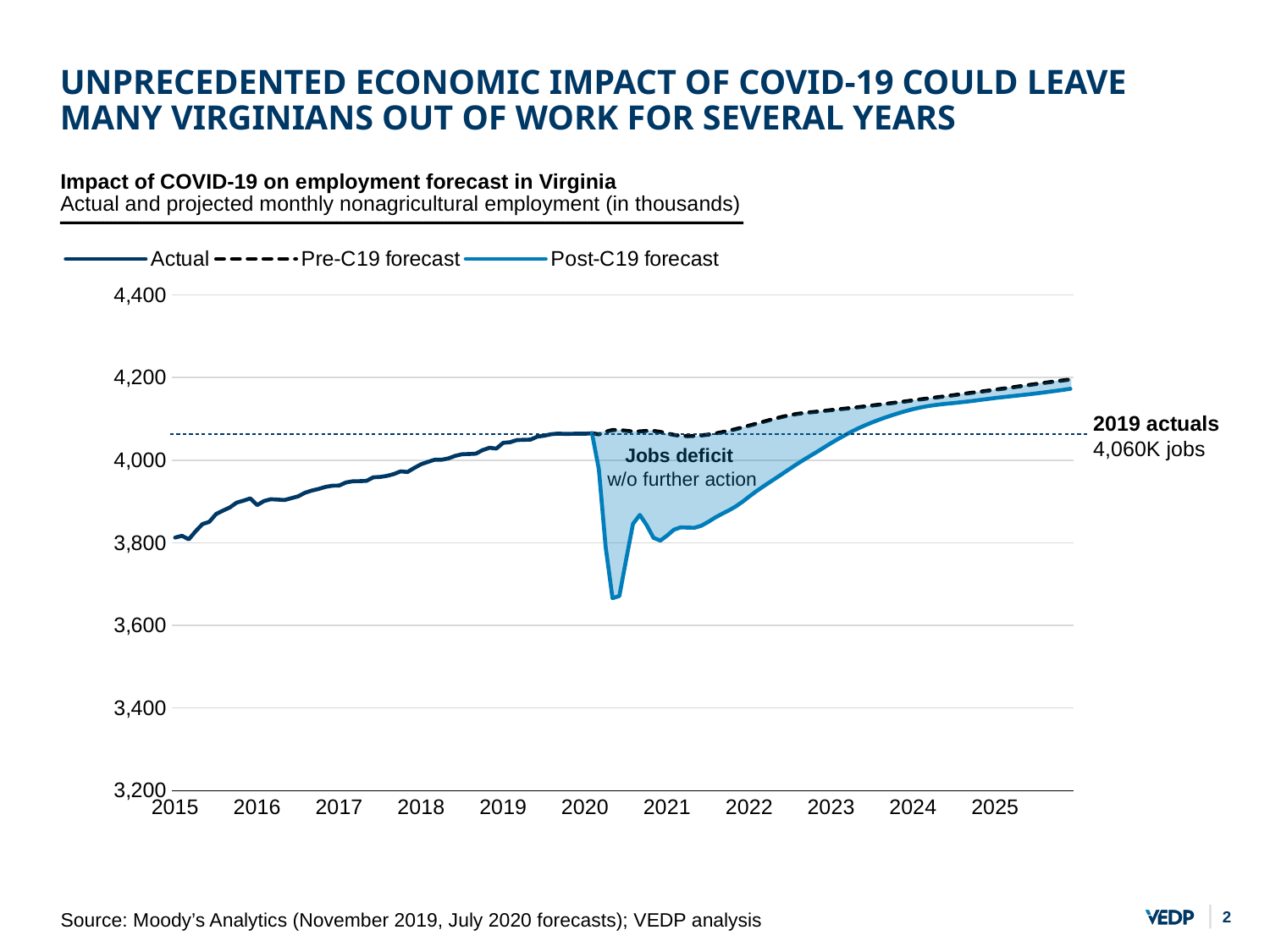
What value is given for 2019 actuals on the chart? 4,060K jobs What does the shaded area between the two forecast lines represent, according to the chart annotation? Jobs deficit w/o further action How many series does the chart legend list? 3 Is the lowest point of the Post-C19 forecast in 2020 greater or less than 3,800? less What kind of chart is shown on the slide? line chart Does the Actual employment line rise or fall from 2015 to 2020? rise How many year labels are shown on the x axis? 11 Is the Actual employment value at 2016 greater or less than 4,000? less Is the Pre-C19 forecast value at 2024 greater or less than 4,000? greater In 2021, which is higher: the Pre-C19 forecast or the Post-C19 forecast? Pre-C19 forecast What is the title of the chart? Impact of COVID-19 on employment forecast in Virginia